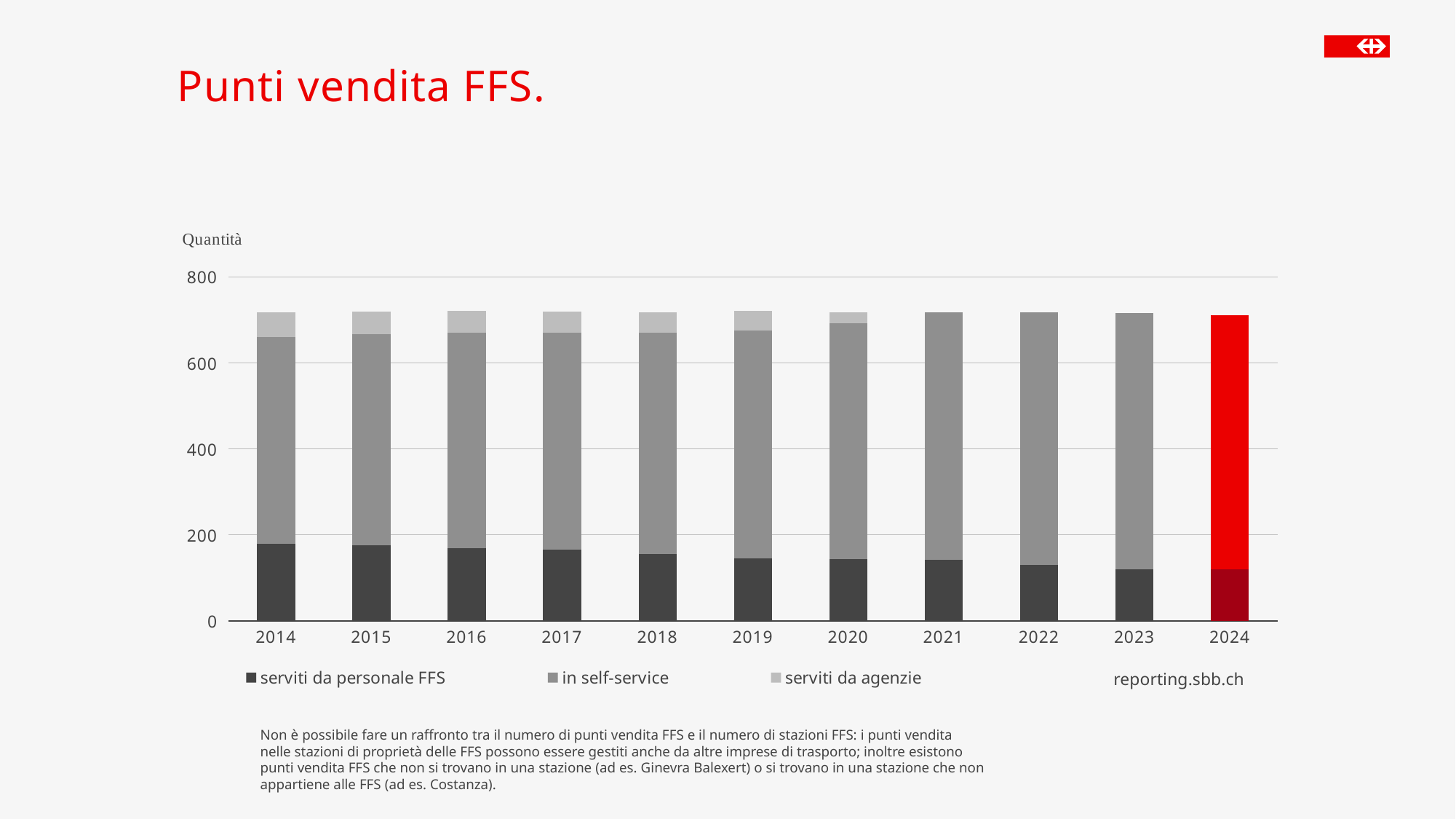
Which series is listed first in the chart legend? serviti da personale FFS How many series does the legend of the chart list? 3 What is the title of the slide containing the chart? Punti vendita FFS. Is the 'serviti da personale FFS' value for 2023 greater or less than 200? less Is the total bar height for 2024 greater or less than 800? less What kind of chart is shown on the slide? stacked bar chart What is the label on the y axis of the chart? Quantità How many years are shown on the x axis of the chart? 11 Is the 'serviti da personale FFS' value for 2014 greater or less than 100? greater Which year has the larger 'serviti da personale FFS' segment, 2014 or 2023? 2014 Does the 'serviti da personale FFS' segment rise or fall from 2014 to 2024? fall